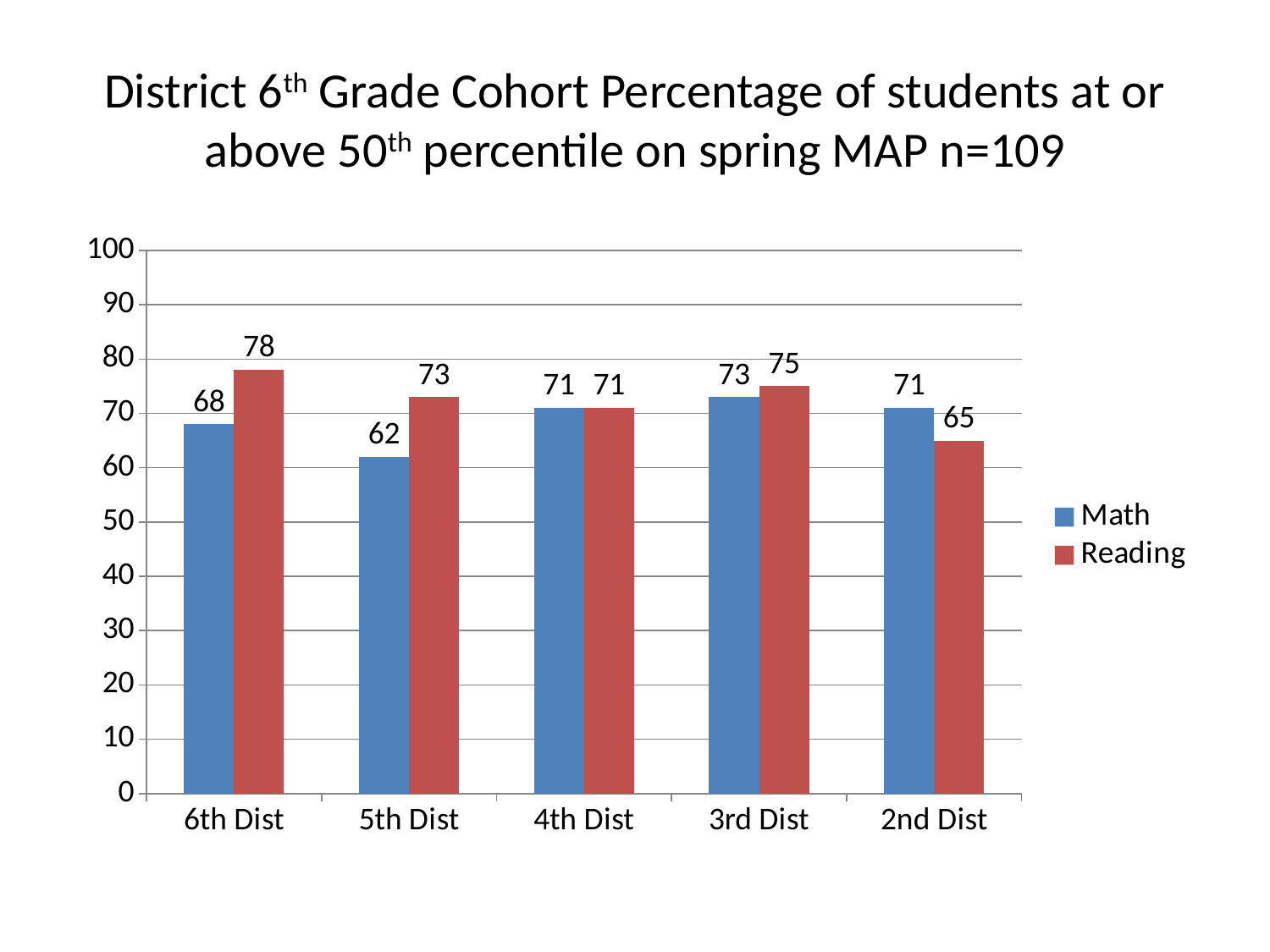
Which category has the lowest Math value? 5th Dist Which colour represents the Reading series? red What is the difference between the Reading and Math values for 6th Dist? 10 Which category has the highest Reading value? 6th Dist What is the Reading value for 6th Dist? 78 Which is larger for 2nd Dist, Math or Reading? Math What kind of chart is shown on the slide? bar chart What is the Math value for 5th Dist? 62 How many categories are shown on the x axis? 5 What is the Reading value for 2nd Dist? 65 Is the Reading value for 3rd Dist greater or less than 70? greater How many series does the legend list? 2